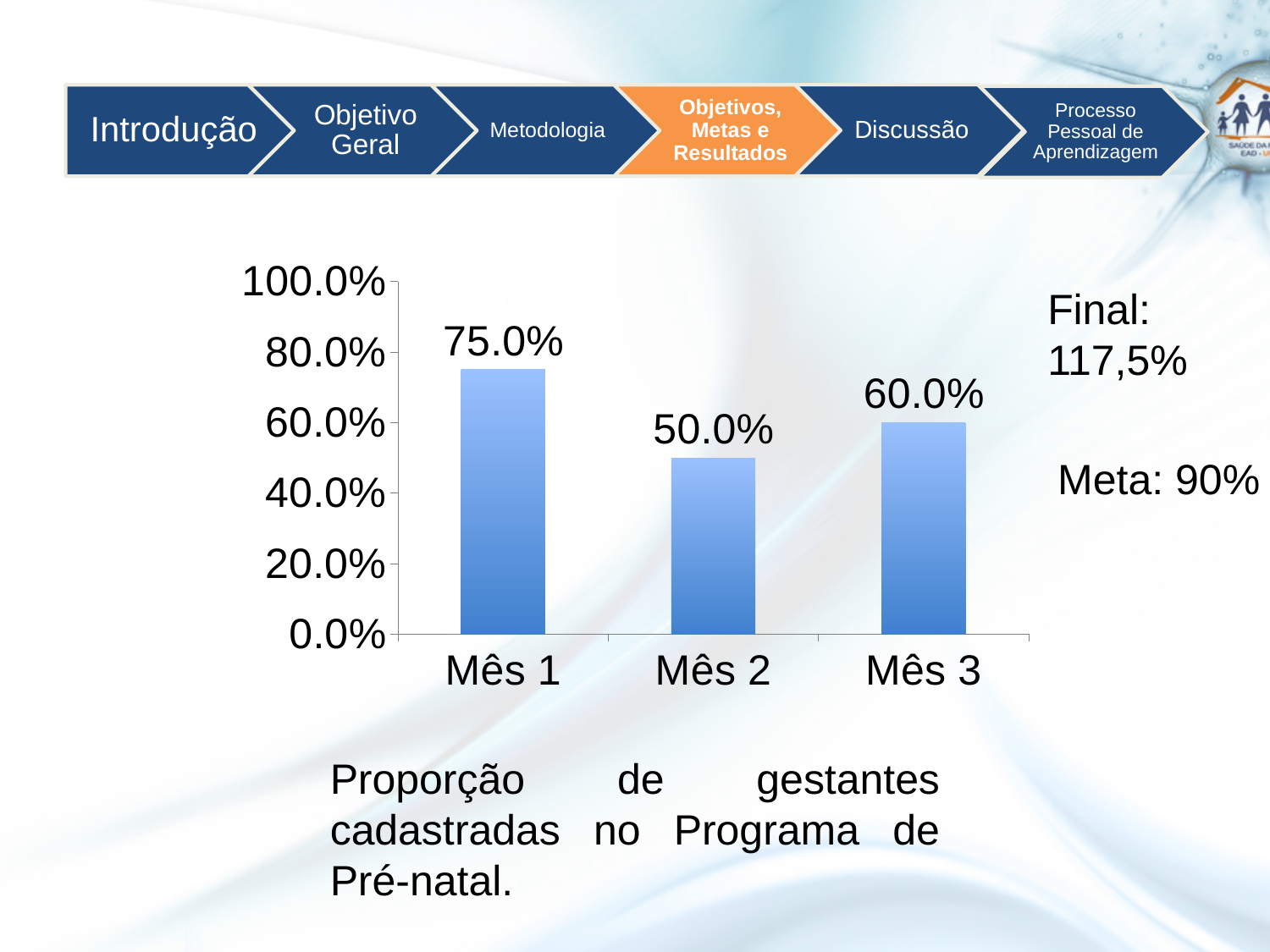
What is the difference between the values for Mês 3 and Mês 2? 10.0% What is the difference between the values for Mês 1 and Mês 2? 25.0% What is the Meta (target) value stated next to the chart? 90% How many months are shown on the x axis? 3 What is the value for Mês 2? 50.0% What is the value for Mês 3? 60.0% Which is larger, the value for Mês 2 or the value for Mês 3? Mês 3 Which month has the highest value? Mês 1 Is the value for Mês 1 greater or less than 80.0%? less What kind of chart is shown on the slide? bar chart What is the value for Mês 1? 75.0% Which month has the lowest value? Mês 2